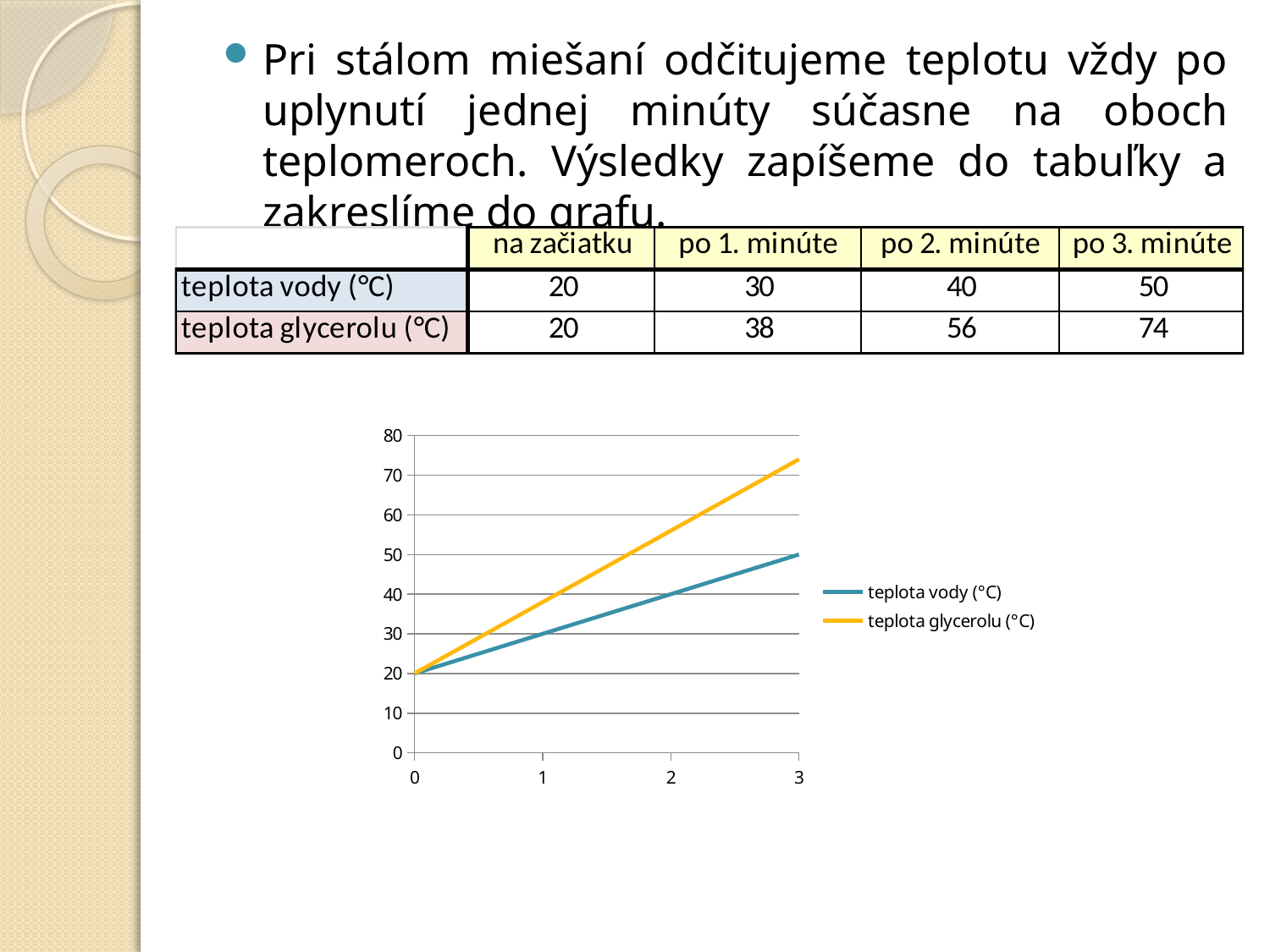
What is the difference between teplota glycerolu (°C) and teplota vody (°C) at minute 3? 24 What colour is the line for teplota glycerolu (°C)? orange How many time points are plotted for each series? 4 What is the value of teplota glycerolu (°C) at minute 3? 74 What is the value of teplota glycerolu (°C) at minute 1? 38 What is the value of teplota vody (°C) at minute 3? 50 Which series is higher at minute 2, teplota vody (°C) or teplota glycerolu (°C)? teplota glycerolu (°C) What kind of chart is shown on the slide? line chart Do the values of teplota vody (°C) rise or fall along the x axis? rise What is the value of teplota vody (°C) at minute 0? 20 Is the value of teplota glycerolu (°C) at minute 2 greater or less than 50? greater How many series does the chart legend list? 2